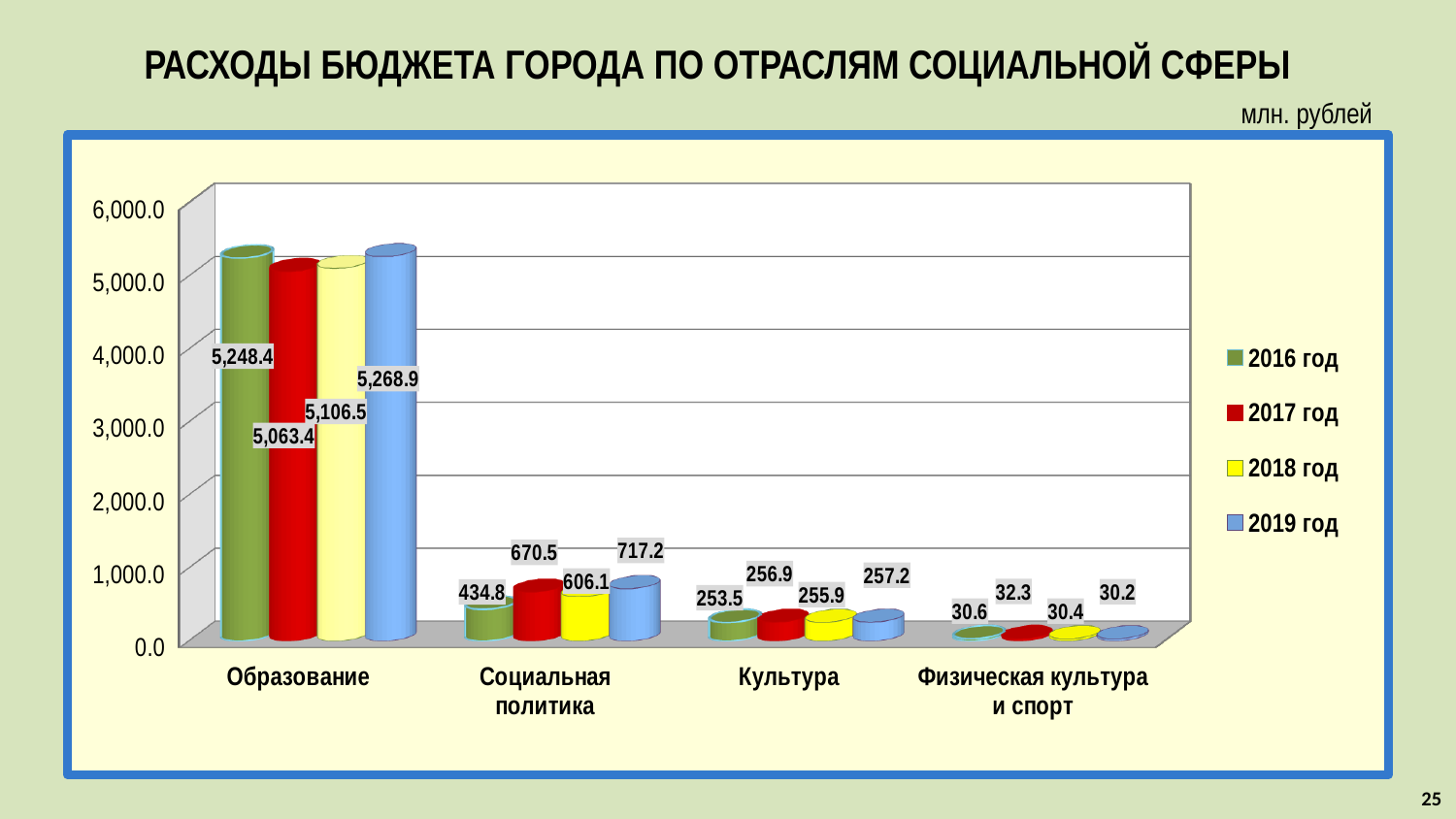
Which category has the lowest value in 2016 год? Физическая культура и спорт What is the difference between the 2019 год and 2016 год values for Социальная политика? 282.4 Which category has the highest value in 2019 год? Образование What kind of chart is shown on the slide? Bar chart What is the value for Физическая культура и спорт in 2017 год? 32.3 What unit of measurement is stated above the chart? млн. рублей What is the value for Социальная политика in 2016 год? 434.8 How many categories are shown on the x axis? 4 What is the value for Культура in 2018 год? 255.9 What is the value for Образование in 2019 год? 5,268.9 How many series does the legend list? 4 Which is larger for Образование: the 2017 год value or the 2018 год value? 2018 год